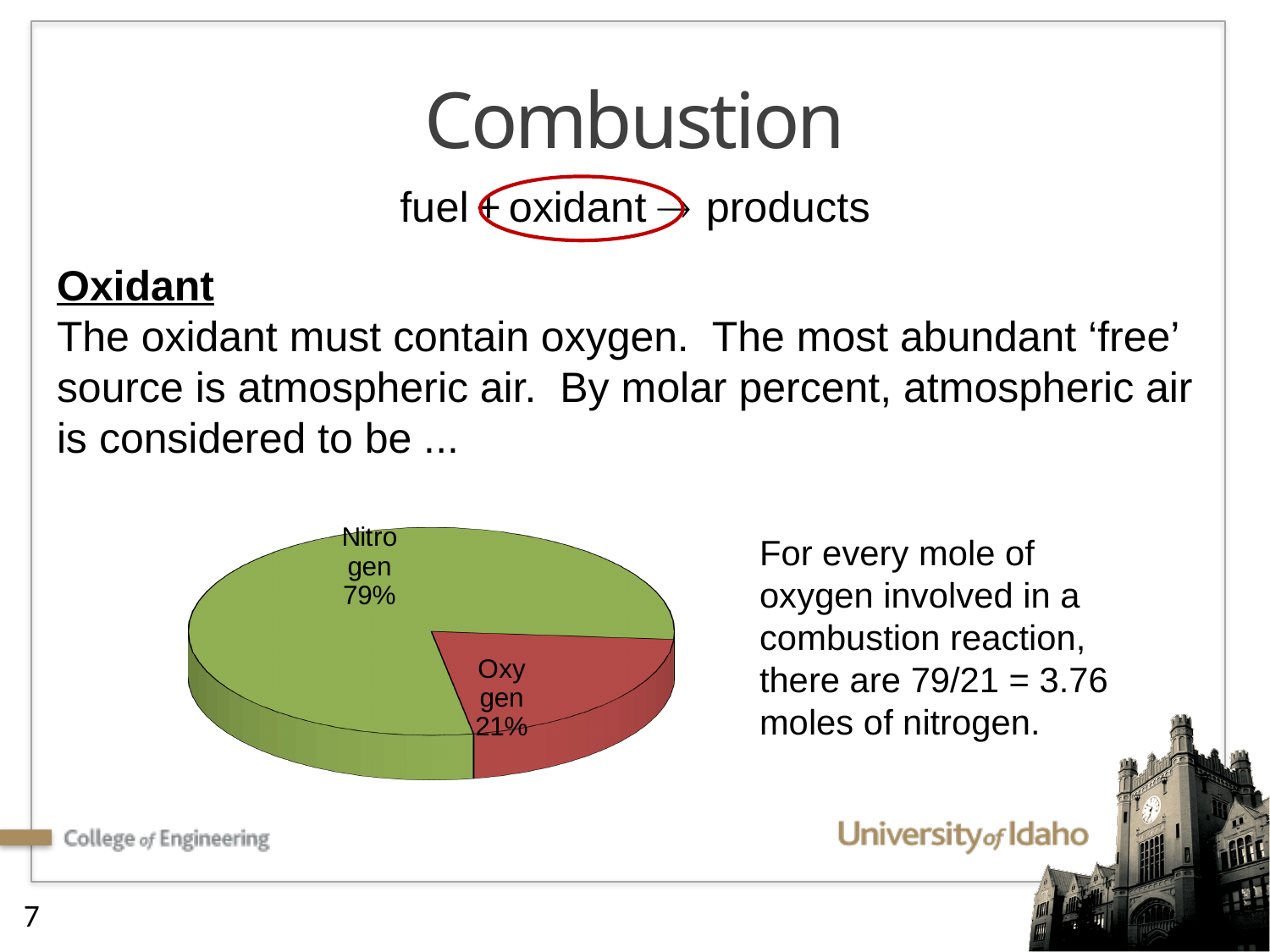
Which slice of the pie chart is the smallest? Oxygen What is the difference in percentage points between the Nitrogen and Oxygen slices? 58 Which is larger in the pie chart, Nitrogen or Oxygen? Nitrogen What kind of chart is shown on the slide? pie chart What percentage of atmospheric air does the pie chart show for Oxygen? 21% What colour is the Oxygen slice in the pie chart? red What percentage of atmospheric air does the pie chart show for Nitrogen? 79% What colour is the Nitrogen slice in the pie chart? green Which slice of the pie chart is the largest? Nitrogen What share of the pie does the Oxygen slice represent? 21% How many slices does the pie chart have? 2